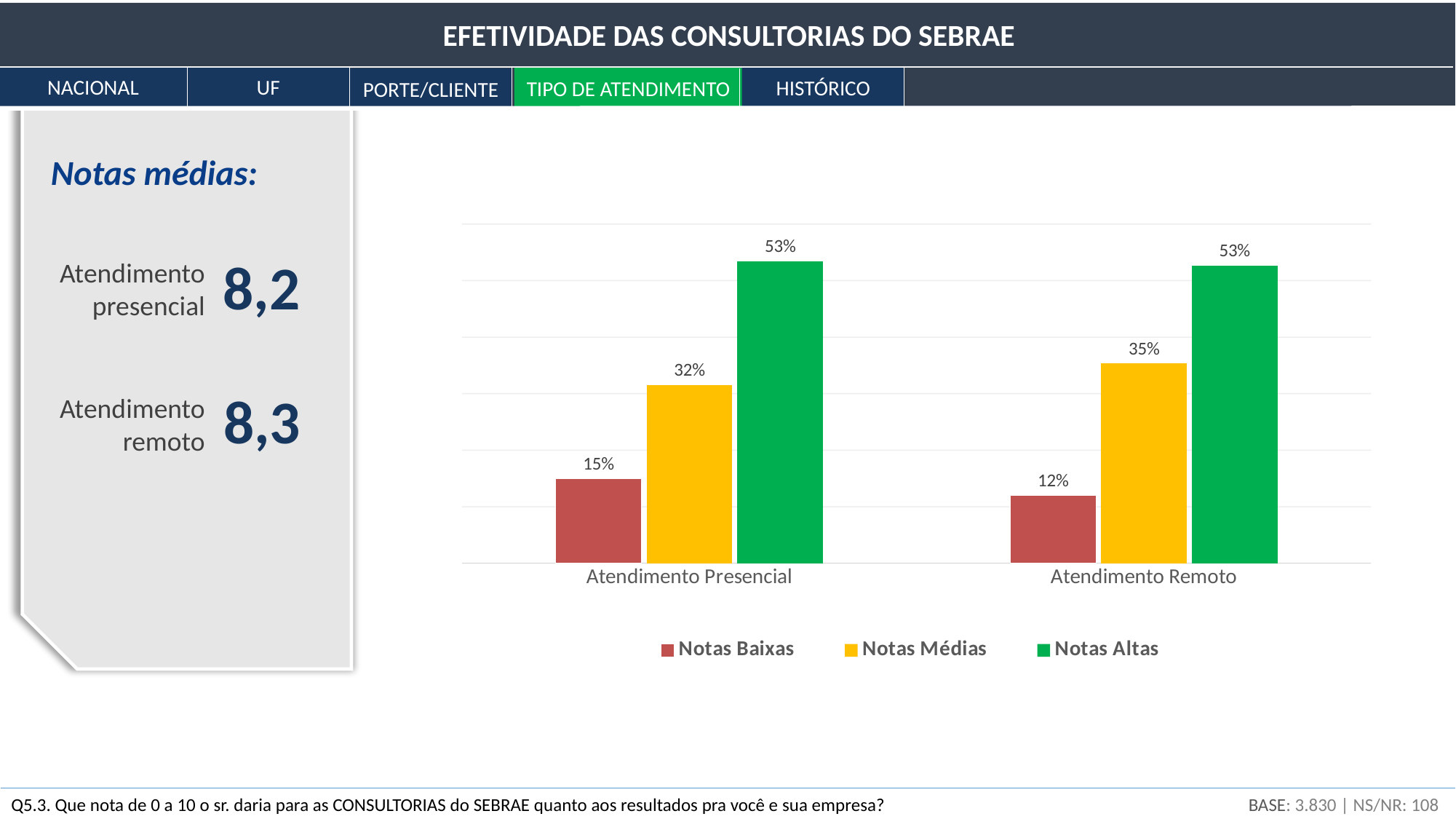
What kind of chart is shown on the slide? Bar chart What is the value for Notas Altas in the Atendimento Presencial category? 53% How many series does the chart legend list? 3 Which is larger: Notas Baixas for Atendimento Presencial or Notas Baixas for Atendimento Remoto? Atendimento Presencial How many categories are shown on the x axis of the chart? 2 What is the difference between Notas Médias for Atendimento Remoto and Notas Médias for Atendimento Presencial? 3% What colour represents the Notas Altas series in the chart? Green What is the value for Notas Médias in the Atendimento Remoto category? 35% Which series has the lowest value in the Atendimento Presencial category? Notas Baixas Which series has the highest value in the Atendimento Remoto category? Notas Altas What is the value for Notas Baixas in the Atendimento Remoto category? 12% What is the value for Notas Baixas in the Atendimento Presencial category? 15%